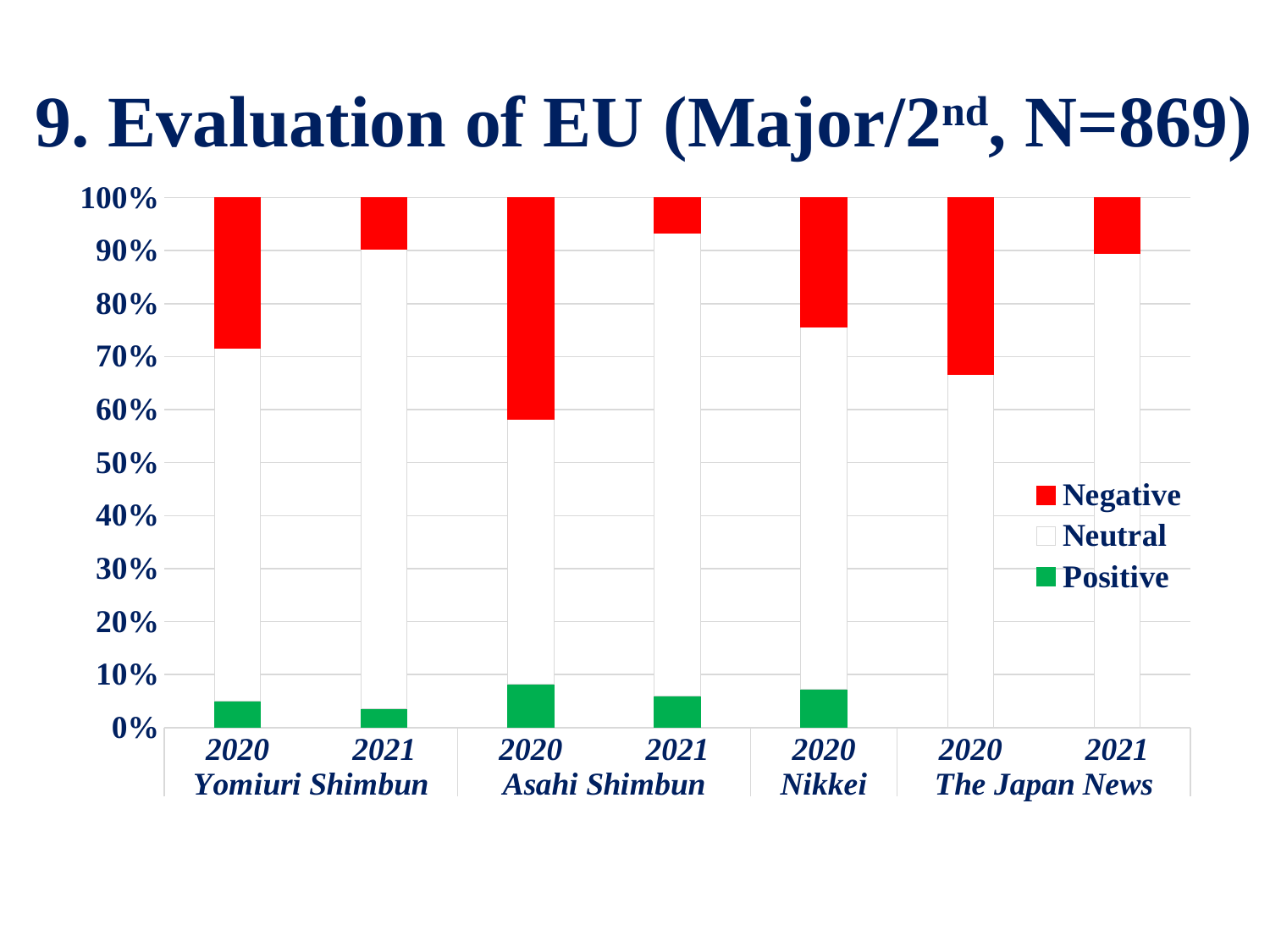
Which bar has the largest Negative segment? Asahi Shimbun 2020 How many series does the legend list? 3 How many stacked bars are plotted in the chart? 7 Which series is shown in red in the legend? Negative Is the Negative share for Yomiuri Shimbun 2020 greater or less than 20%? greater What is the title of the chart on the slide? 9. Evaluation of EU (Major/2nd, N=869) Which has the larger Negative share, Asahi Shimbun 2020 or Asahi Shimbun 2021? Asahi Shimbun 2020 Is the Neutral share for Yomiuri Shimbun 2021 greater or less than 80%? greater Is the Positive share for Asahi Shimbun 2020 greater or less than 10%? less What kind of chart is shown on the slide? Stacked bar chart For Yomiuri Shimbun, does the Negative share rise or fall from 2020 to 2021? fall